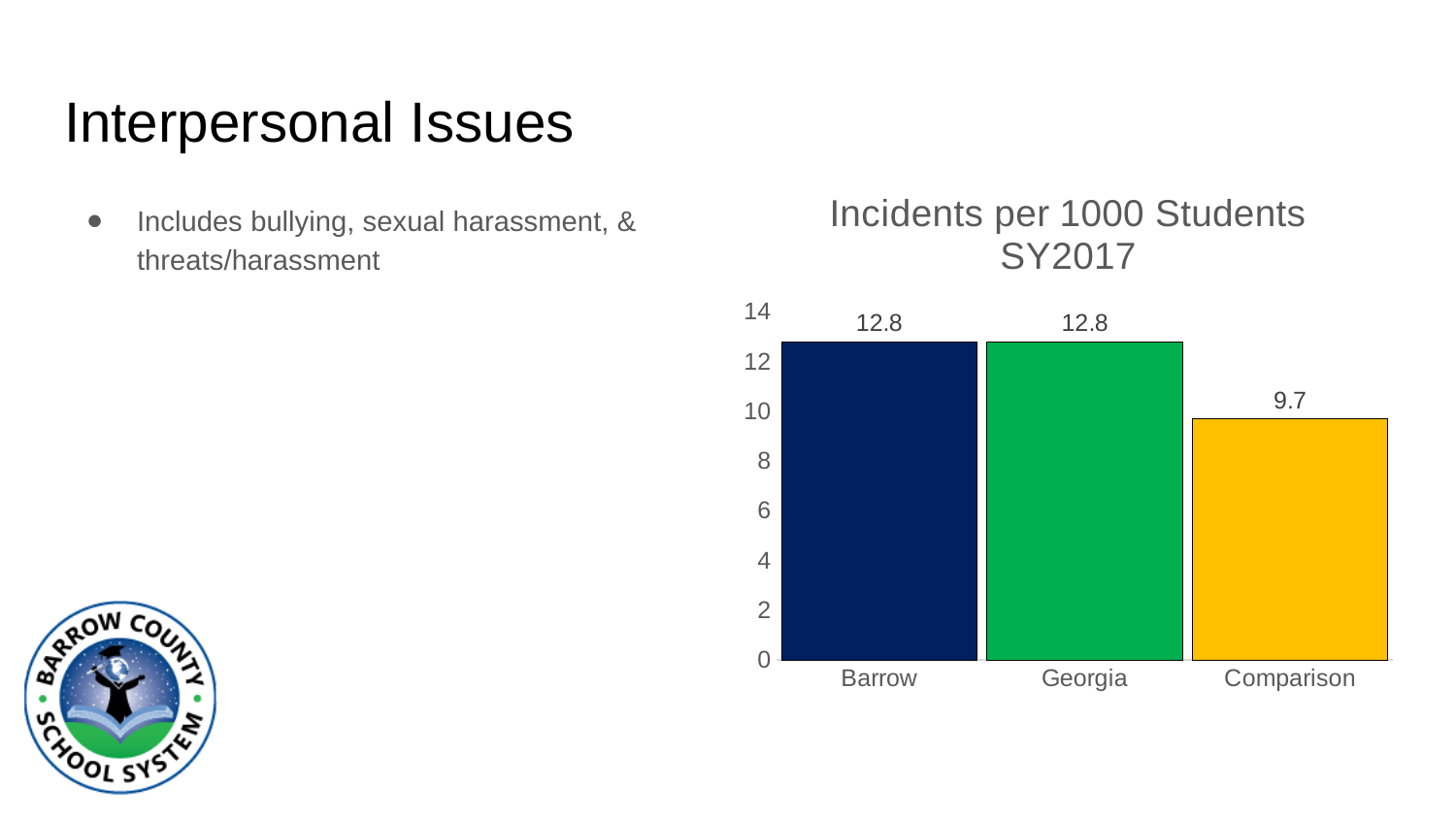
Which category has the lowest value in the chart? Comparison What is the difference between the Georgia value and the Comparison value? 3.1 What is the value for Barrow in the Incidents per 1000 Students SY2017 chart? 12.8 What kind of chart is shown on the slide? bar chart What is the value for Georgia in the Incidents per 1000 Students SY2017 chart? 12.8 What is the title of the chart? Incidents per 1000 Students SY2017 How many categories are shown in the chart? 3 What is the difference between the Barrow value and the Comparison value? 3.1 Is the value for Barrow greater or less than 12? greater Which is larger, the value for Georgia or the value for Comparison? Georgia Is the value for Comparison greater or less than 10? less What is the value for Comparison in the Incidents per 1000 Students SY2017 chart? 9.7